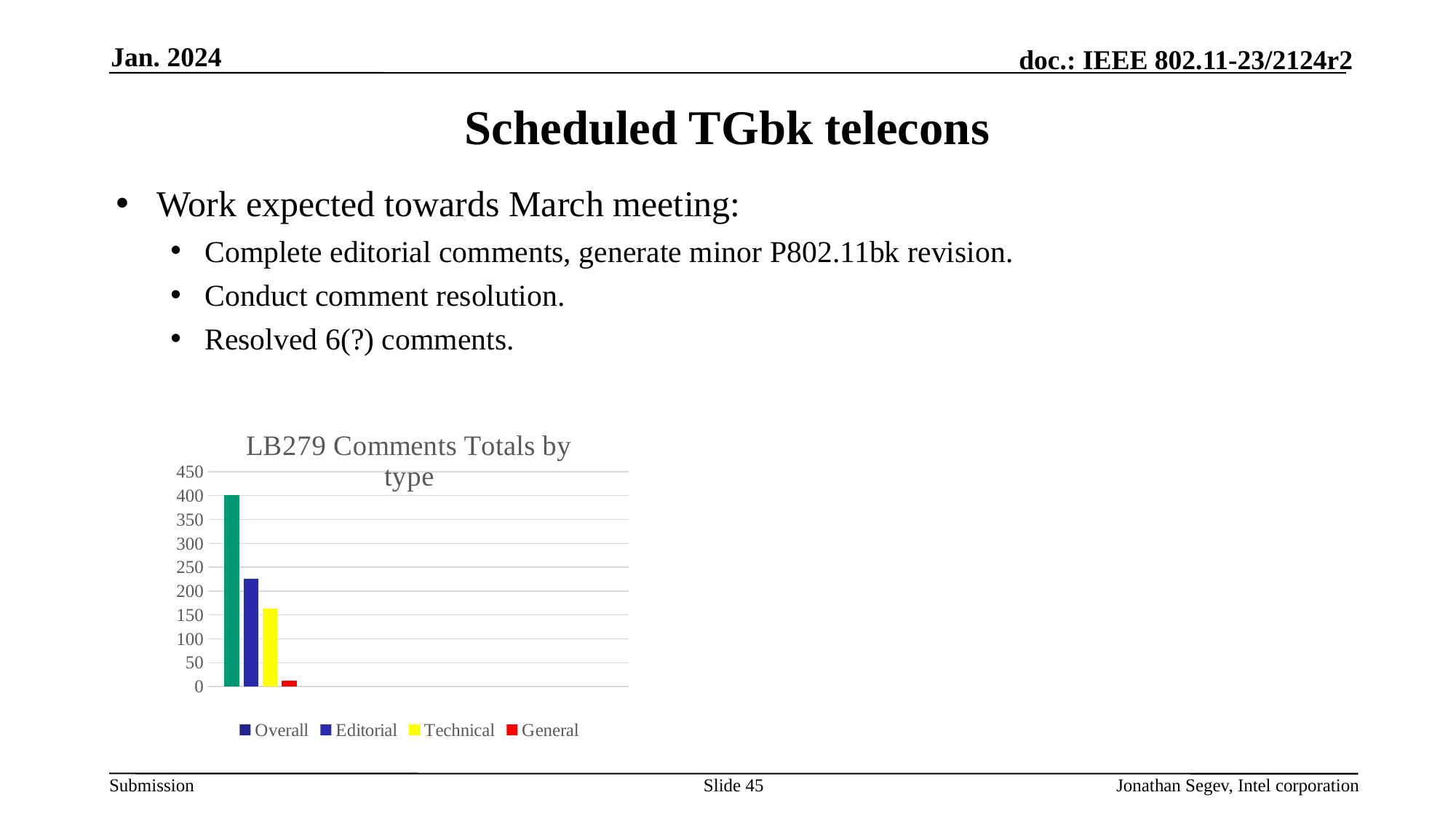
Is the value for Editorial greater or less than 300? less Which series has the highest value in the chart? Overall How many series does the legend of the chart list? 4 Which series has the lowest value in the chart? General Is the value for Editorial greater or less than 200? greater Is the value for Overall greater or less than 350? greater What kind of chart is shown on the slide? bar chart What is the title of the chart? LB279 Comments Totals by type What is the highest value shown on the chart's vertical axis? 450 Which is larger, the value for Editorial or the value for Technical? Editorial